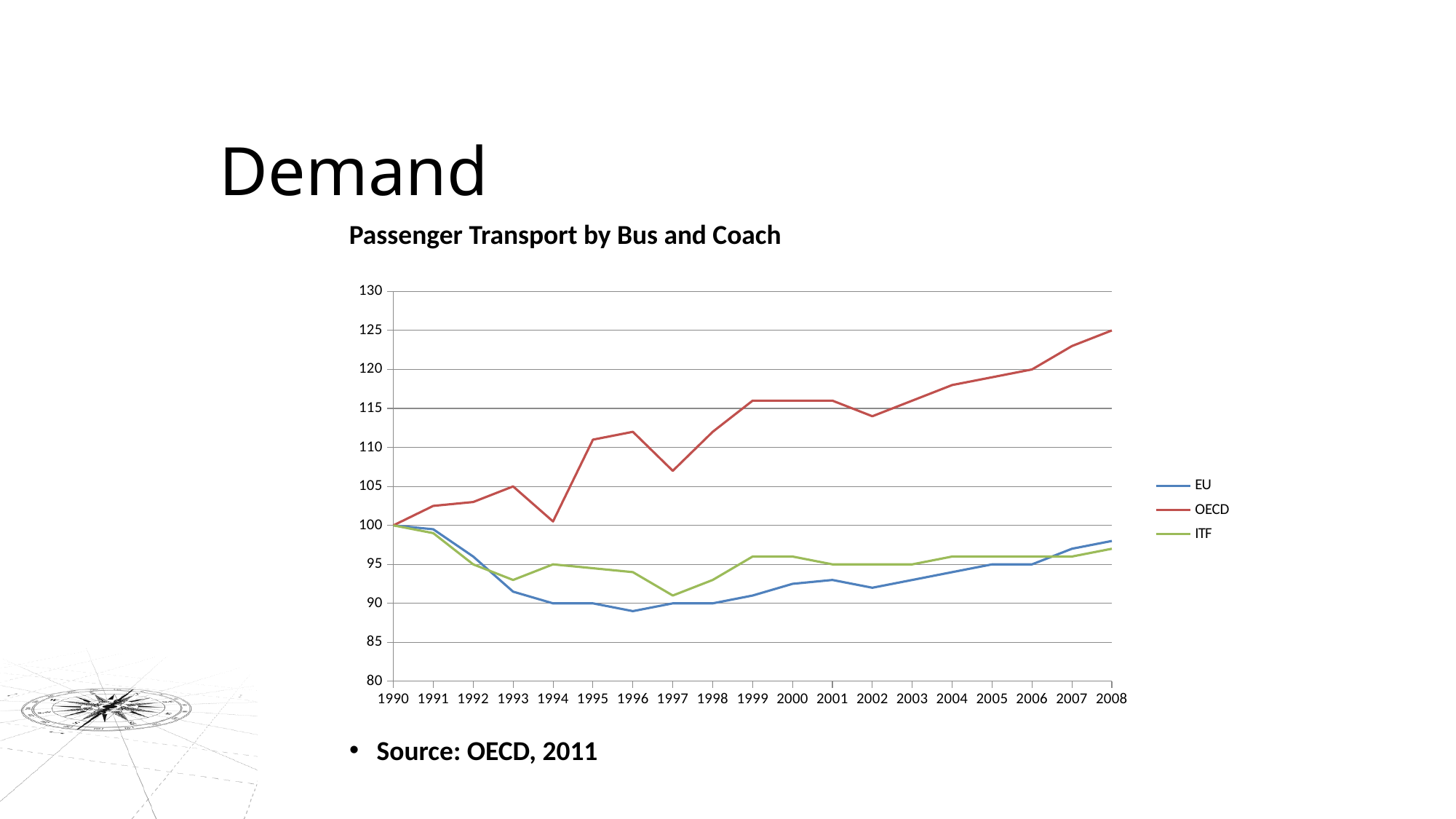
In 2002, which series has the larger value, OECD or EU? OECD Is the ITF value in 1997 greater or less than 95? less Does the OECD series generally rise or fall from 1990 to 2008? rise What type of chart is shown on the slide? line chart Which series has the highest value in 2008? OECD How many years are shown along the x axis? 19 Is the EU value in 1996 greater or less than 90? less What is the title of the chart? Passenger Transport by Bus and Coach What is the value for all three series in 1990? 100 Is the OECD value in 2008 greater or less than 120? greater Which series has the lowest value in 1996? EU How many series does the legend list? 3